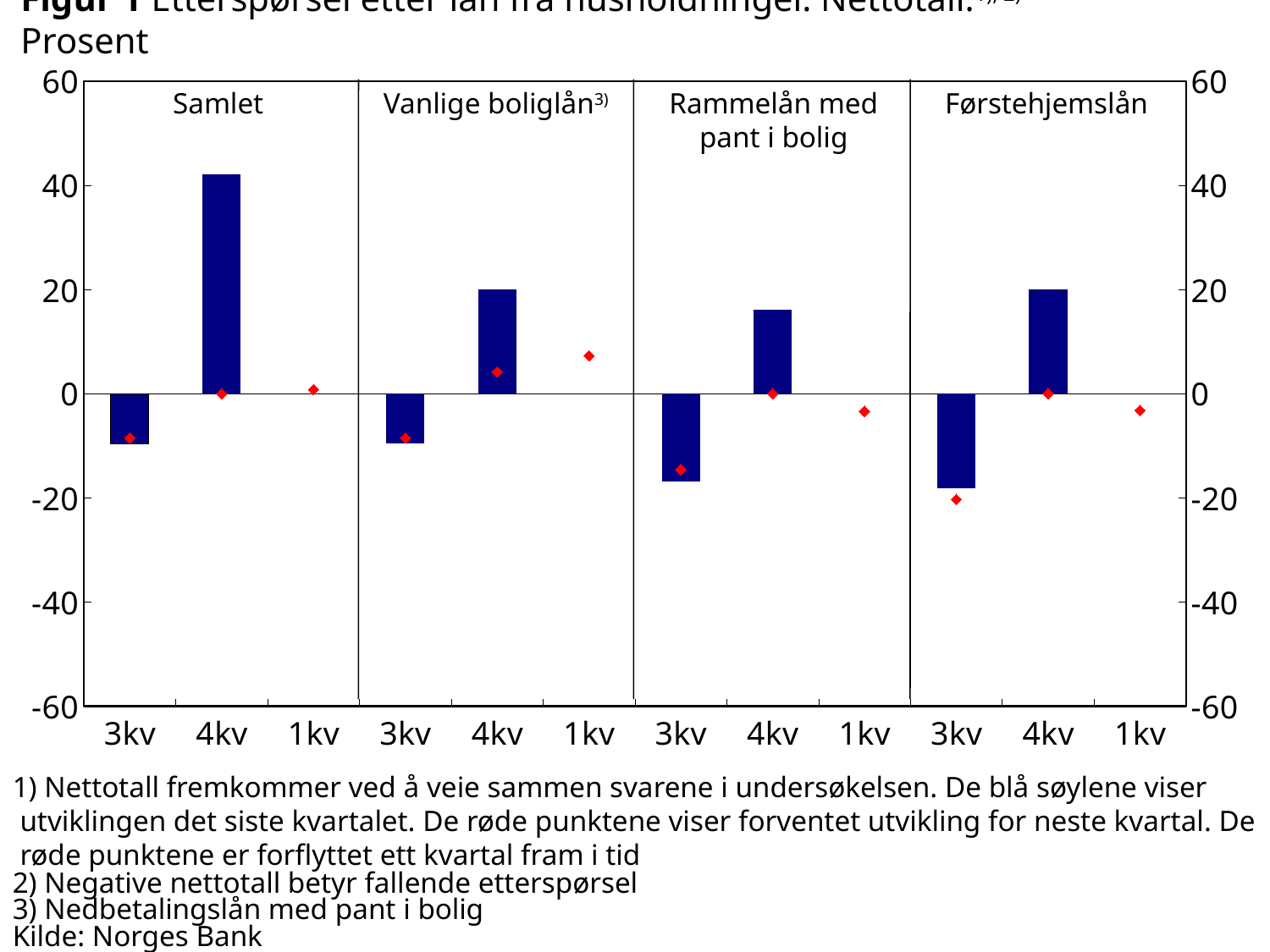
What kind of chart is shown on the slide? bar chart Is the 3kv bar for Rammelån med pant i bolig greater or less than -10? less In the Samlet panel, do the bars rise or fall from 3kv to 4kv? rise Which panel has the highest bar for 4kv? Samlet How many loan categories (panels) are shown in the chart? 4 What unit is the y axis measured in, according to the label under the title? Prosent Which is larger, the 4kv bar for Samlet or the 4kv bar for Vanlige boliglån? Samlet How many quarters are labelled on the x axis within each panel? 3 Is the 4kv bar for Samlet greater or less than 40? greater Which is larger, the 4kv bar for Rammelån med pant i bolig or the 4kv bar for Førstehjemslån? Førstehjemslån Is the 4kv bar for Vanlige boliglån greater or less than 10? greater What is the source of the chart data? Norges Bank